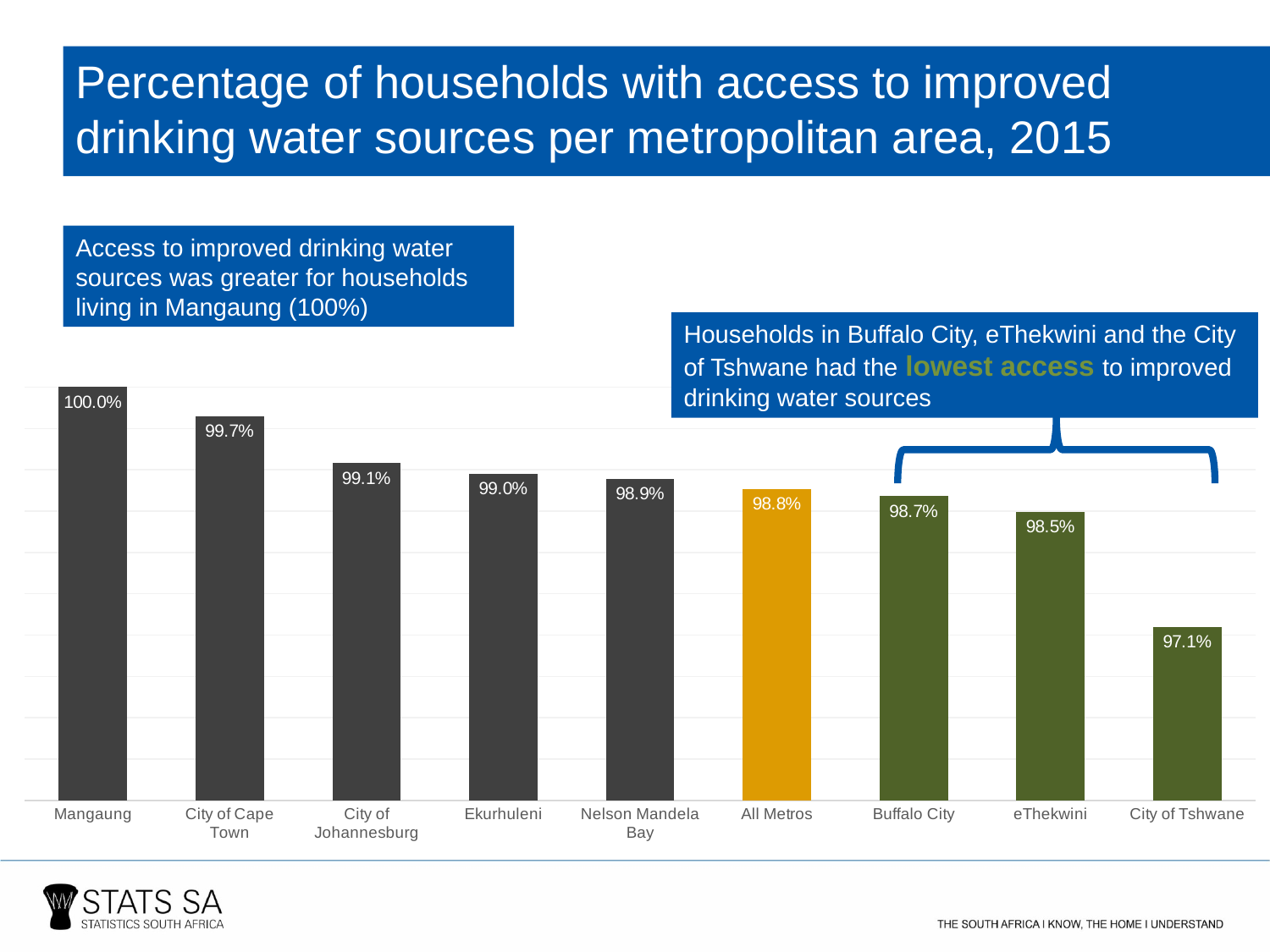
Which has a higher value, City of Johannesburg or eThekwini? City of Johannesburg What is the difference between the values for Mangaung and City of Tshwane? 2.9% Which metropolitan area has the lowest percentage of households with access to improved drinking water sources? City of Tshwane Which metropolitan area has the highest percentage of households with access to improved drinking water sources? Mangaung How many bars are shown in the chart? 9 What is the value shown for City of Tshwane? 97.1% What type of chart is shown on the slide? Bar chart Which bar is coloured orange/gold rather than grey or green? All Metros What is the value shown for eThekwini? 98.5% What is the percentage of households with access to improved drinking water sources in Mangaung? 100.0% What is the value shown for All Metros? 98.8% What is the difference between the values for City of Cape Town and Buffalo City? 1.0%